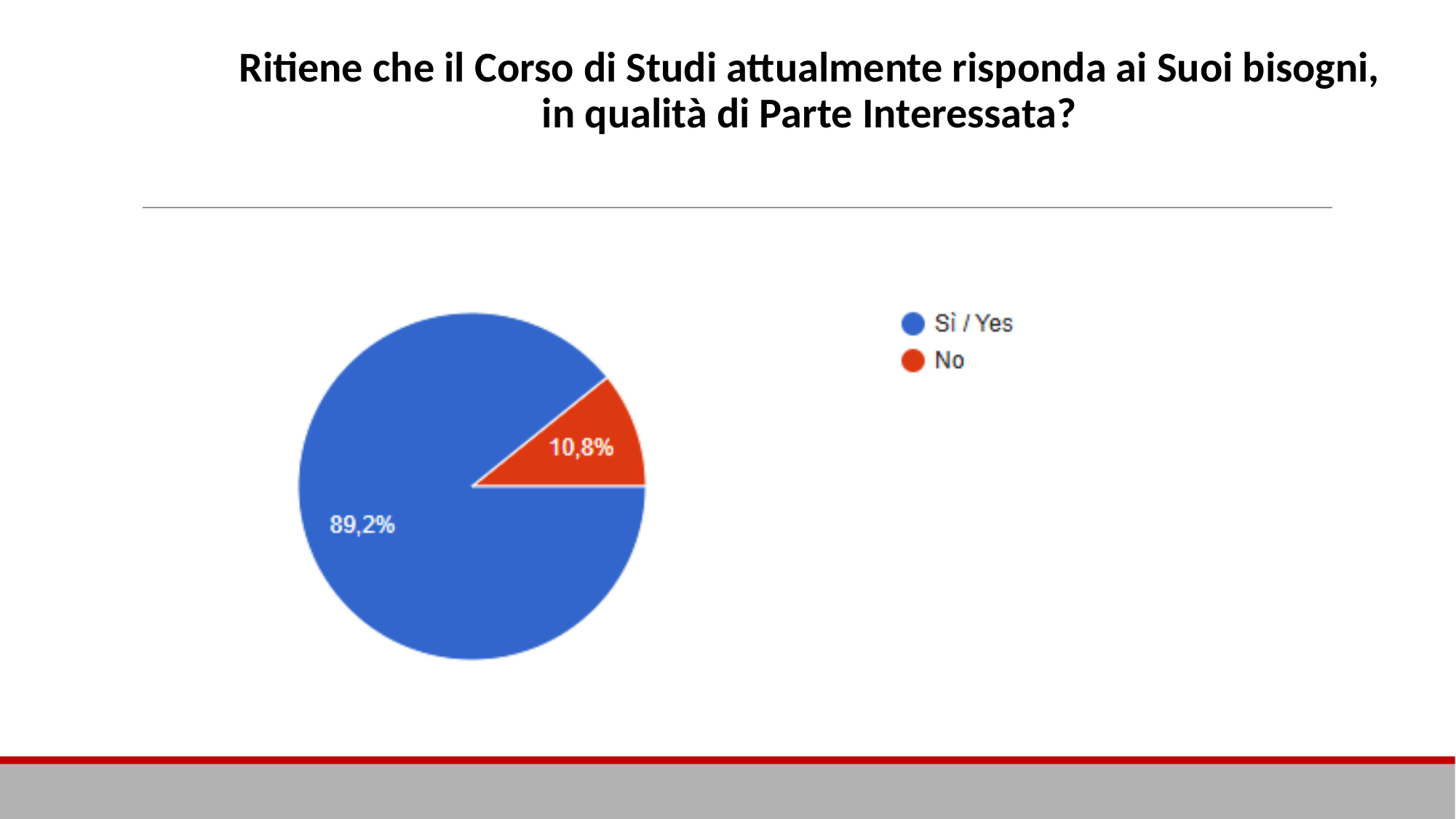
What kind of chart is shown on the slide? Pie chart What is the difference in percentage points between the "Sì / Yes" and "No" slices? 78,4 What colour is the "No" slice in the pie chart? Red What colour is the "Sì / Yes" slice in the pie chart? Blue Which slice is the largest in the pie chart? Sì / Yes What share of the pie does the "Sì / Yes" slice represent? 89,2% Which slice is the smallest in the pie chart? No Which is larger, the "Sì / Yes" slice or the "No" slice? Sì / Yes How many entries does the legend list? 2 How many slices does the pie chart have? 2 What share of the pie does the "No" slice represent? 10,8%